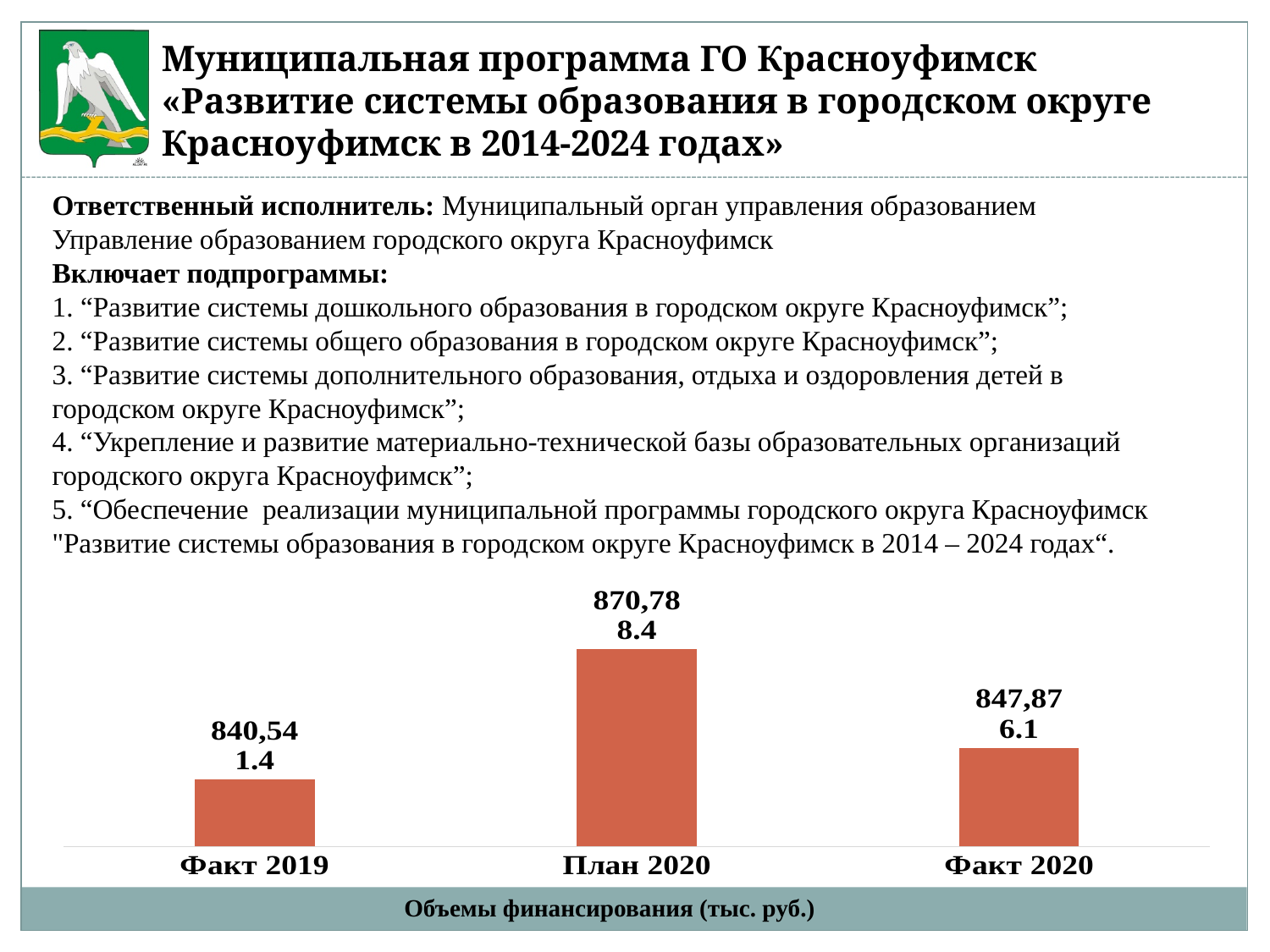
Which category has the lowest value? Факт 2019 What is the value for Факт 2020? 847,876.1 What kind of chart is shown on the slide? Bar chart How many categories are shown in the chart? 3 What is the difference between План 2020 and Факт 2019? 30,247.0 What is the value for План 2020? 870,788.4 Which is larger, Факт 2020 or Факт 2019? Факт 2020 What is the value for Факт 2019? 840,541.4 What is the difference between План 2020 and Факт 2020? 22,912.3 What is the difference between Факт 2020 and Факт 2019? 7,334.7 What is the title of the chart? Объемы финансирования (тыс. руб.) Which category has the highest value? План 2020